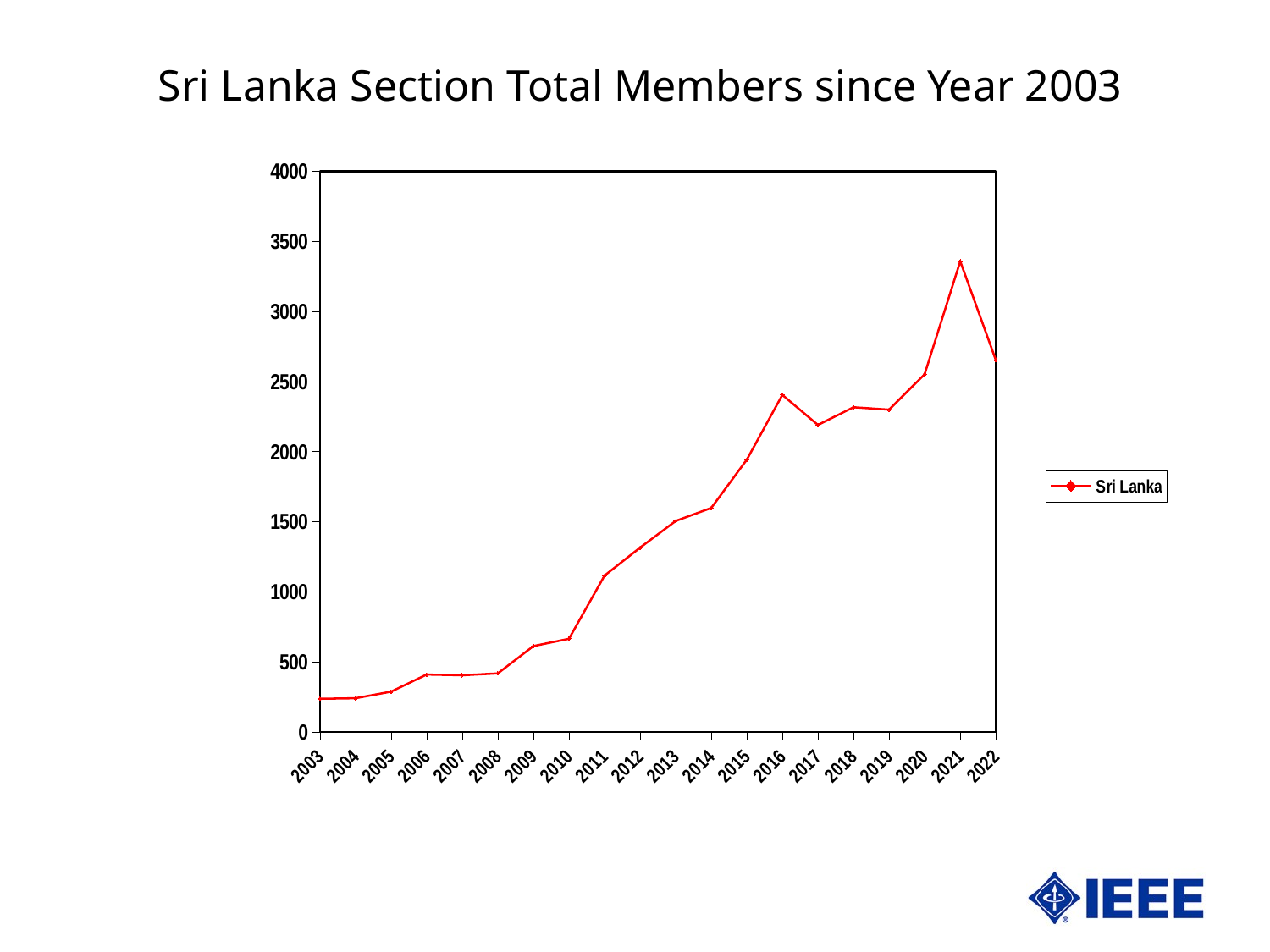
Is the value for 2021 greater or less than 3000? greater Which year has the highest number of members? 2021 Which year has the larger value, 2016 or 2017? 2016 Overall, do the values rise or fall from 2003 to 2021? rise How many years are plotted along the x axis? 20 How many series does the legend list? 1 Which year has the larger value, 2021 or 2022? 2021 Is the value for 2003 greater or less than 500? less Is the value for 2016 greater or less than 2000? greater What kind of chart is shown on the slide? line chart What is the title of the chart? Sri Lanka Section Total Members since Year 2003